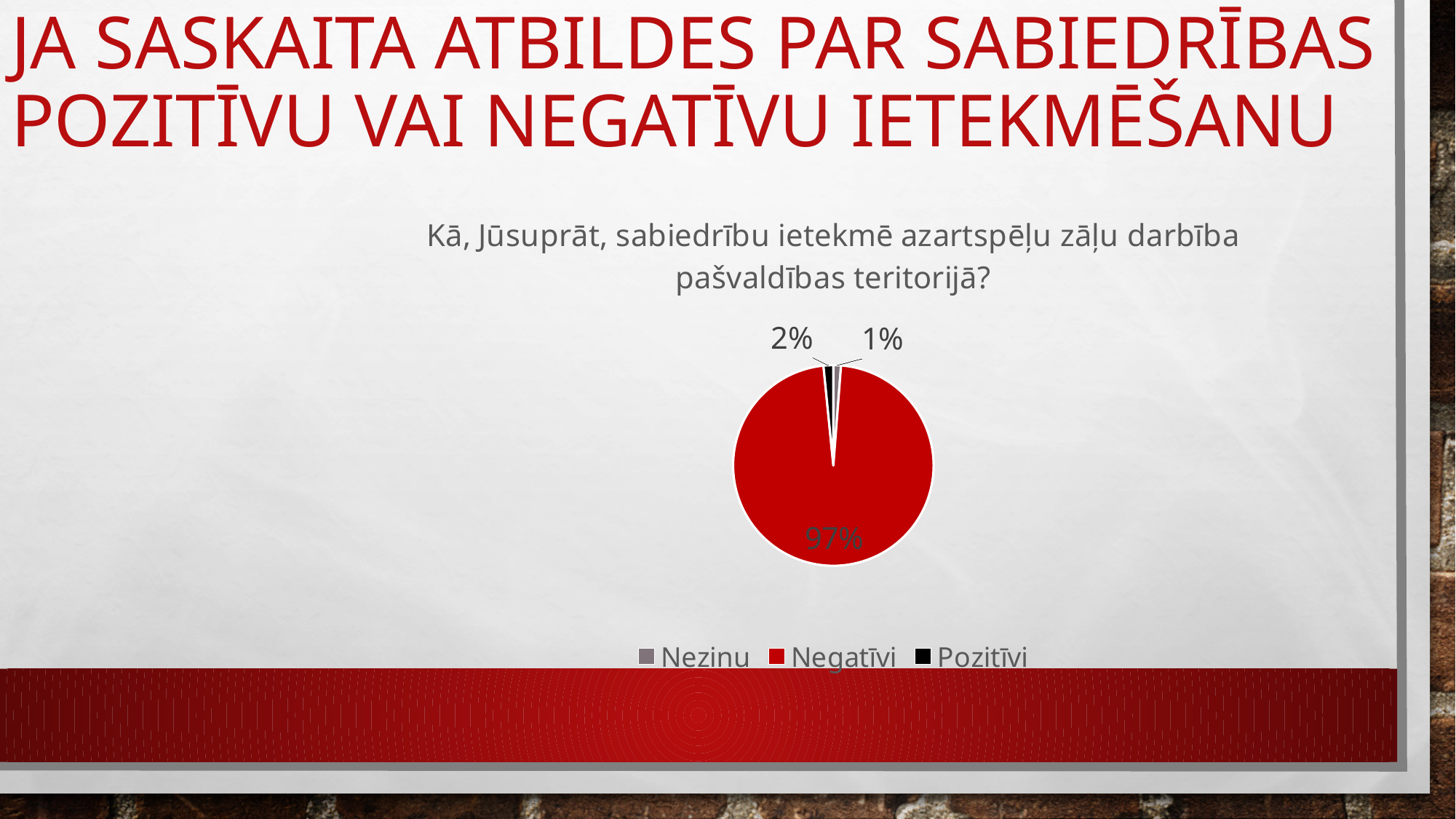
What is the title of the chart? Kā, Jūsuprāt, sabiedrību ietekmē azartspēļu zāļu darbība pašvaldības teritorijā? How many categories does the pie chart have? 3 What percentage of respondents answered Nezinu? 1% What percentage of respondents answered Pozitīvi? 2% What is the difference in percentage points between Negatīvi and Pozitīvi? 95 What colour is the Negatīvi slice? red How many entries does the legend list? 3 What percentage of respondents answered Negatīvi? 97% Which is larger, the share for Pozitīvi or the share for Nezinu? Pozitīvi Which answer has the smallest share of the pie? Nezinu What kind of chart is shown on the slide? pie chart Which answer has the largest share of the pie? Negatīvi